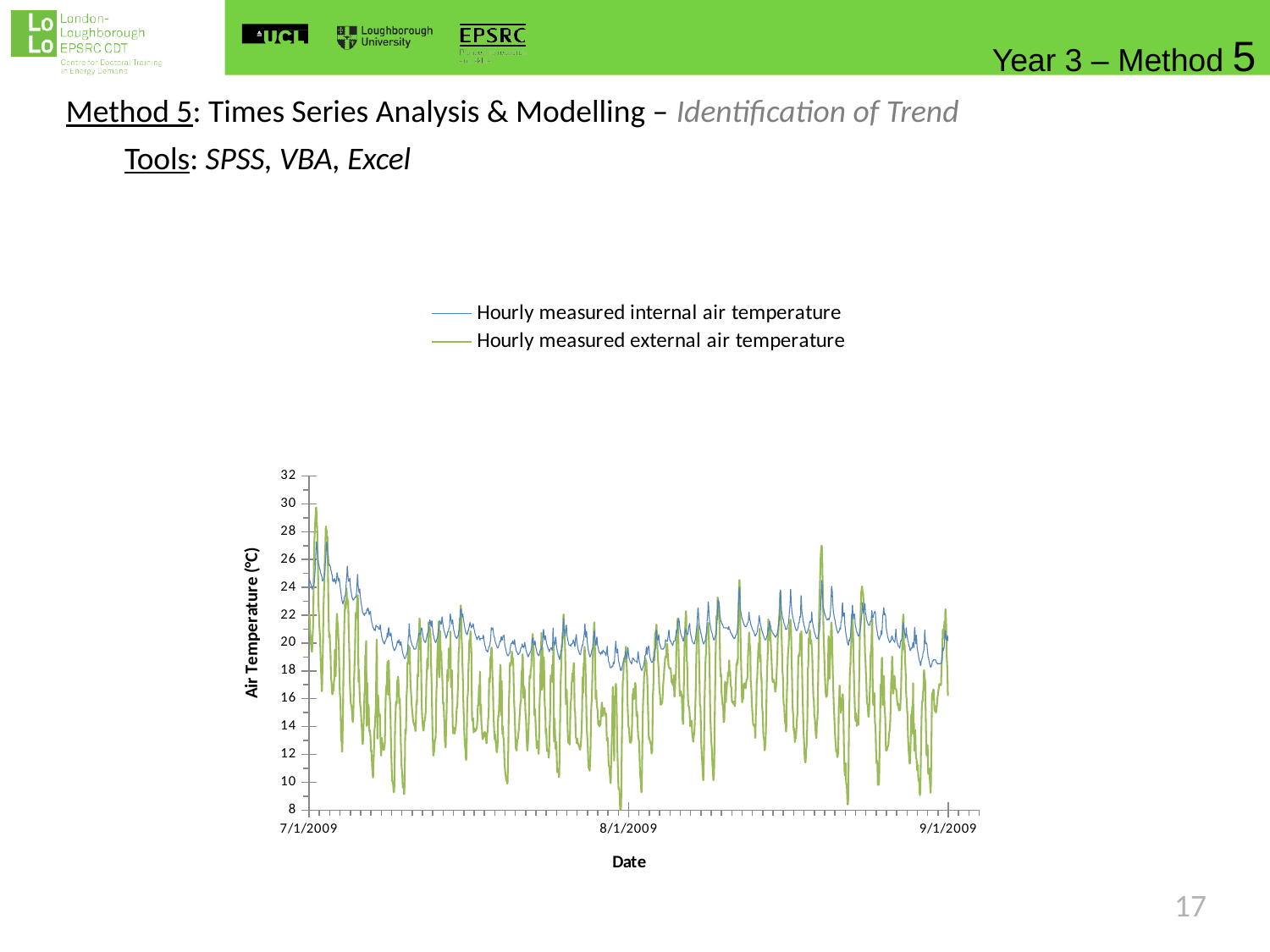
Which series is generally higher across the period, internal or external air temperature? Hourly measured internal air temperature Which series reaches the lowest temperature on the chart, internal or external air temperature? Hourly measured external air temperature How many series does the chart's legend list? 2 How many date labels are printed along the chart's x axis? 3 What are the two series named in the chart's legend? Hourly measured internal air temperature; Hourly measured external air temperature Is the lowest external air temperature on the chart greater or less than 10? less Which series shows the larger day-to-day swings in temperature, internal or external? Hourly measured external air temperature What kind of chart is shown on the slide? Line chart What is the title of the chart's vertical axis? Air Temperature (°C) Is the highest external air temperature on the chart greater or less than 28? greater Is the lowest internal air temperature on the chart greater or less than 16? greater